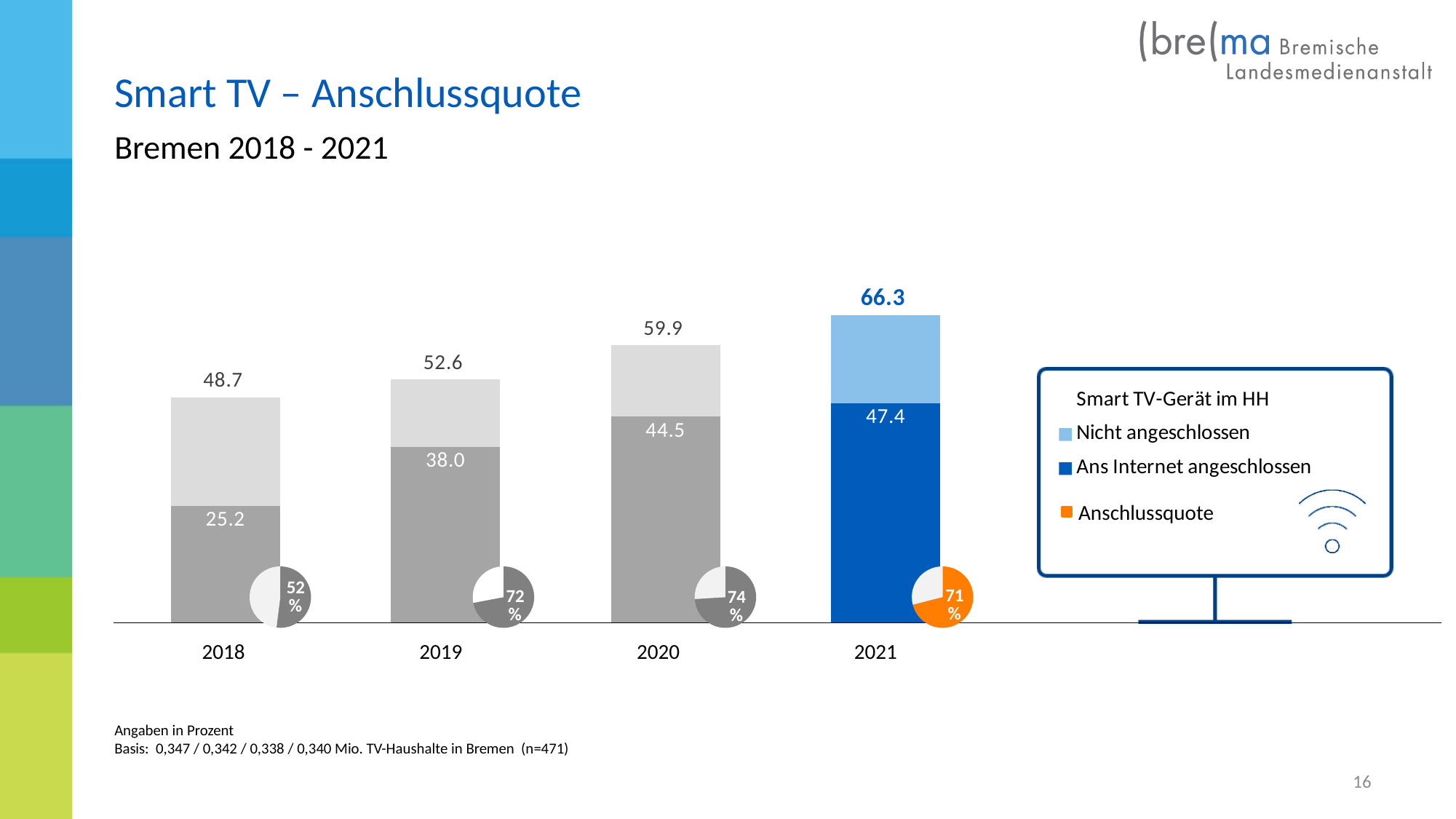
Which year has the lowest value for 'Ans Internet angeschlossen'? 2018 What is the total value of the stacked bar for 2021? 66.3 What is the value for 'Ans Internet angeschlossen' in 2020? 44.5 What Anschlussquote is shown in the small pie for 2018? 52% Do the total stacked bar values rise or fall from 2018 to 2021? rise What kind of chart is used to show the Smart TV values per year? stacked bar chart Which is larger: the Anschlussquote for 2020 or for 2021? 2020 Which year has the highest total stacked bar value? 2021 What is the difference between the total bar values for 2021 and 2018? 17.6 What is the 'Nicht angeschlossen' portion of the 2021 bar (total minus 'Ans Internet angeschlossen')? 18.9 How many years are shown on the x axis? 4 What is the value for 'Ans Internet angeschlossen' in 2019? 38.0